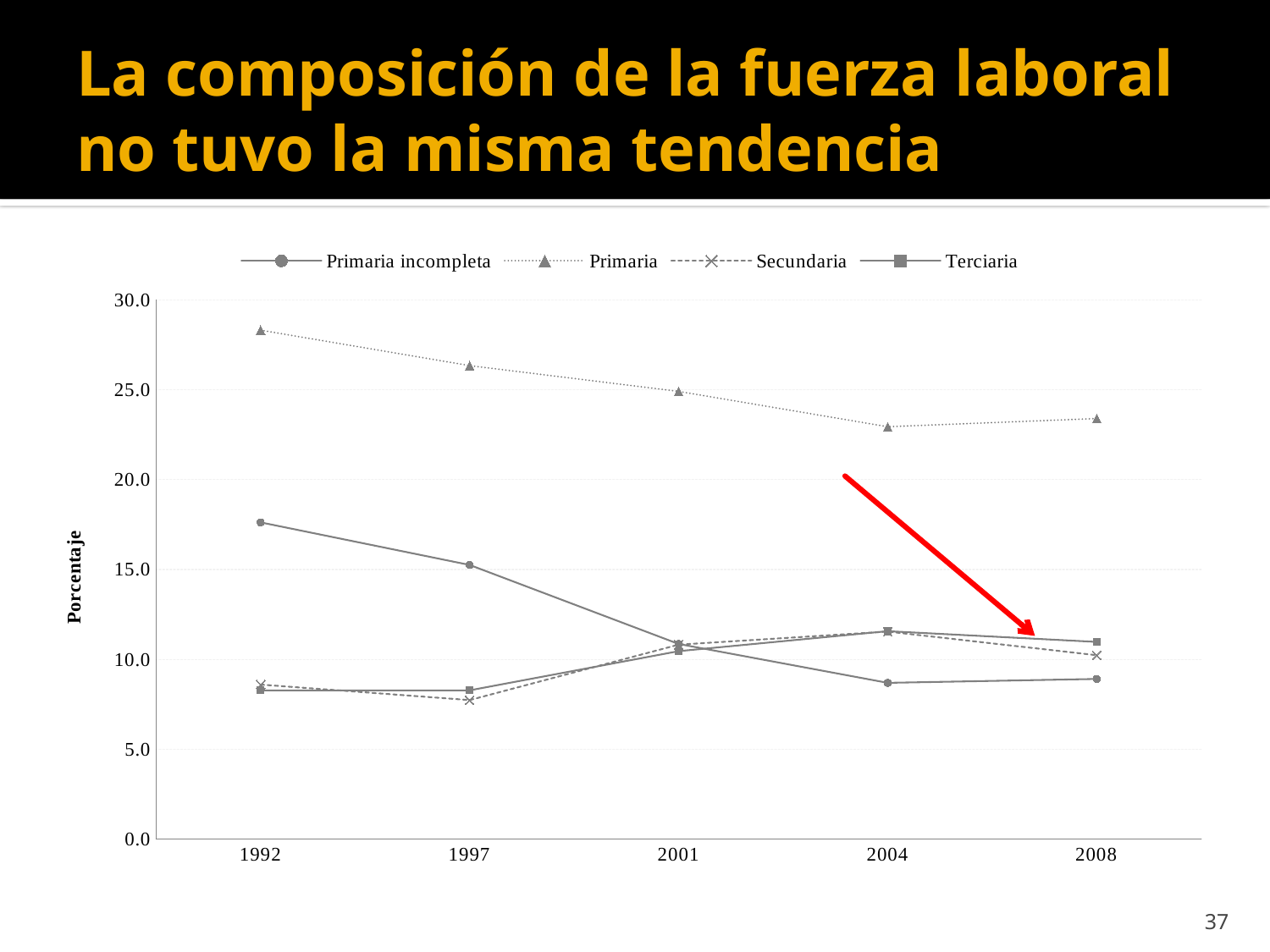
Is the value for Primaria in 1992 greater or less than 25.0? greater Is the value for Primaria incompleta in 1992 greater or less than 15.0? greater Which series has the highest value in 1992? Primaria How many series does the legend list? 4 How many years are shown on the x axis? 5 Is the value for Primaria in 2004 greater or less than 25.0? less Which is larger: the value for Terciaria in 1992 or in 2008? 2008 What is the label on the y axis? Porcentaje Does the Primaria incompleta series rise or fall from 1992 to 2004? fall What kind of chart is shown on the slide? line chart Which series has the lowest value in 2008? Primaria incompleta